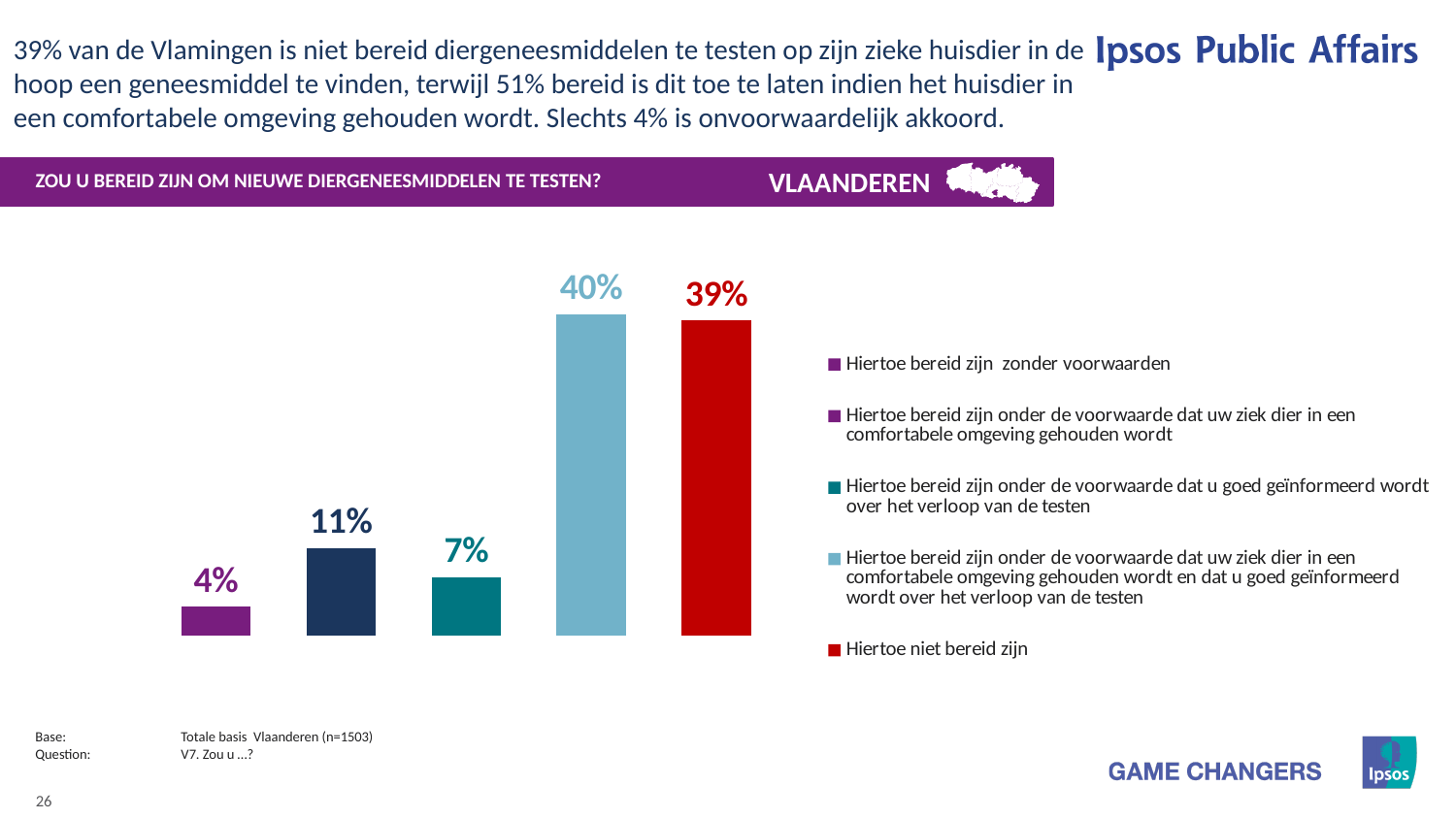
How many entries does the legend list? 5 Which category has the highest value in the chart? Hiertoe bereid zijn onder de voorwaarde dat uw ziek dier in een comfortabele omgeving gehouden wordt en dat u goed geïnformeerd wordt over het verloop van de testen What percentage is shown for 'Hiertoe niet bereid zijn'? 39% Which category has the lowest value in the chart? Hiertoe bereid zijn zonder voorwaarden What percentage is shown for 'Hiertoe bereid zijn zonder voorwaarden'? 4% What type of chart is shown on the slide? Bar chart What percentage is shown for the bar 'Hiertoe bereid zijn onder de voorwaarde dat uw ziek dier in een comfortabele omgeving gehouden wordt'? 11% What percentage is shown for the bar 'Hiertoe bereid zijn onder de voorwaarde dat u goed geïnformeerd wordt over het verloop van de testen'? 7% Which is larger: the value for the 'comfortabele omgeving' condition alone (11%) or the 'goed geïnformeerd' condition alone (7%)? Hiertoe bereid zijn onder de voorwaarde dat uw ziek dier in een comfortabele omgeving gehouden wordt What colour is the bar for 'Hiertoe niet bereid zijn'? Red How many bars are plotted in the chart? 5 What is the difference between the value for 'Hiertoe niet bereid zijn' and the value for 'Hiertoe bereid zijn zonder voorwaarden'? 35%